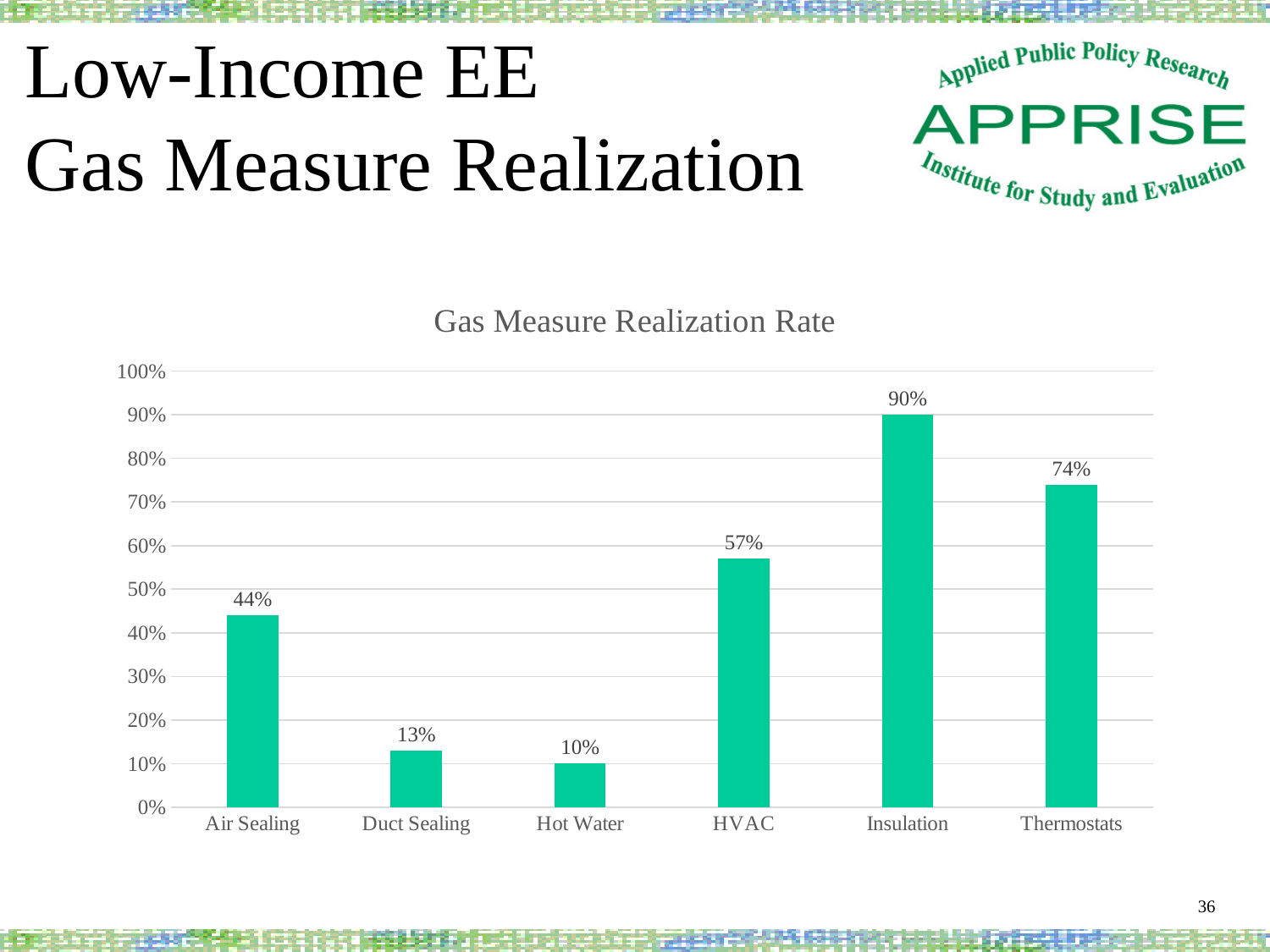
What is the gas measure realization rate for HVAC? 57% Which measure has the highest realization rate? Insulation How many measure categories are shown on the chart? 6 Is the realization rate for Thermostats greater or less than 70%? greater What is the difference between the realization rates for Insulation and HVAC? 33% What is the gas measure realization rate for Duct Sealing? 13% What is the gas measure realization rate for Insulation? 90% What is the difference between the realization rates for Thermostats and Air Sealing? 30% Which measure has the lowest realization rate? Hot Water What type of chart is shown on the slide? Bar chart Which has a higher realization rate, Air Sealing or HVAC? HVAC What is the title of the chart? Gas Measure Realization Rate